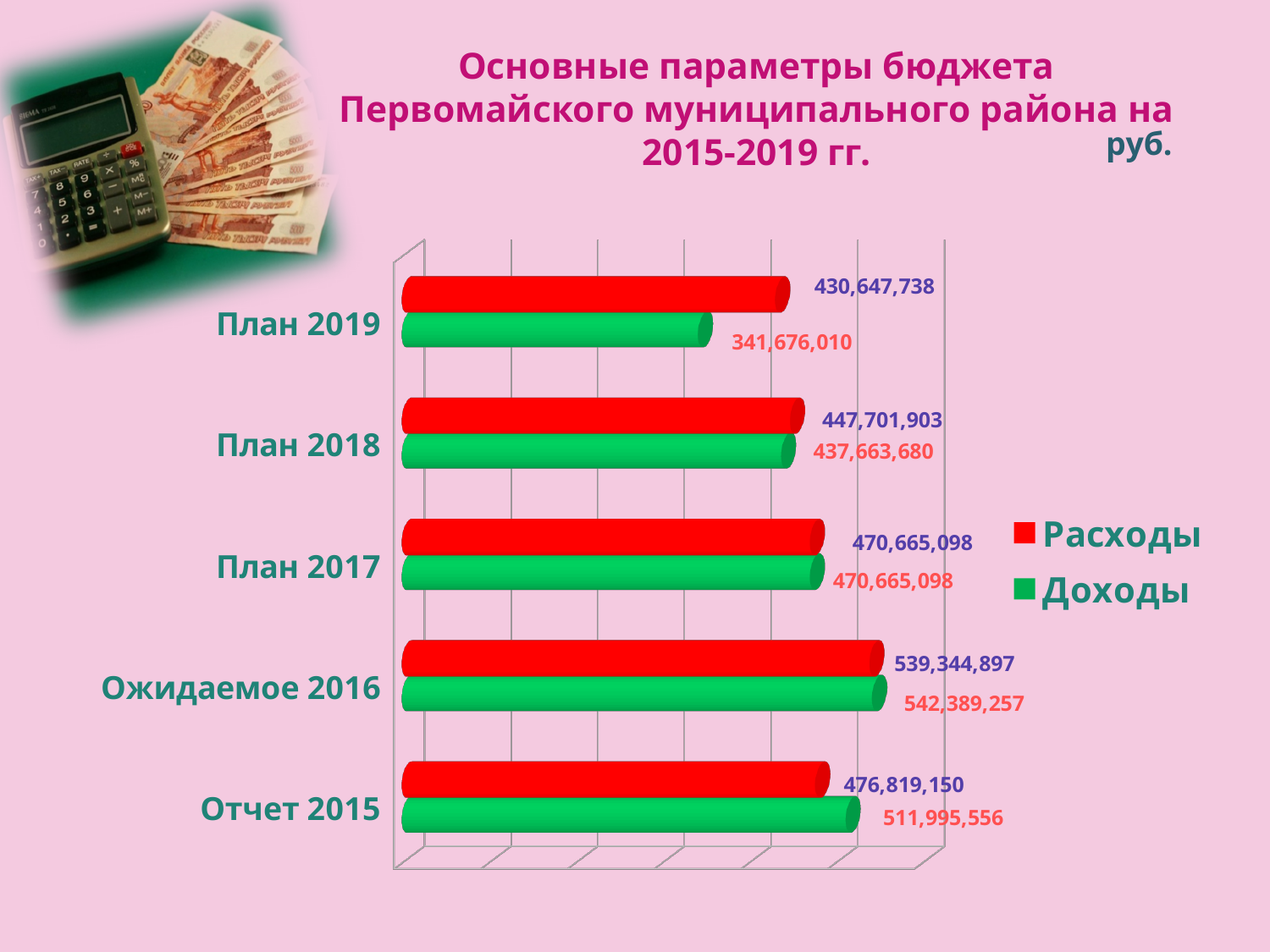
What is the difference between Доходы and Расходы for Отчет 2015? 35,176,406 What is the value of Доходы for Отчет 2015? 511,995,556 Which category has the highest Расходы value? Ожидаемое 2016 What kind of chart is shown on the slide? Bar chart What is the difference between Расходы and Доходы for План 2019? 88,971,728 Which category has the lowest Доходы value? План 2019 For Ожидаемое 2016, which is larger: Расходы or Доходы? Доходы What is the value of Расходы for План 2019? 430,647,738 Which colour represents Доходы in the chart? Green What is the value of Доходы for План 2018? 437,663,680 How many categories are shown on the chart? 5 How many series does the legend list? 2